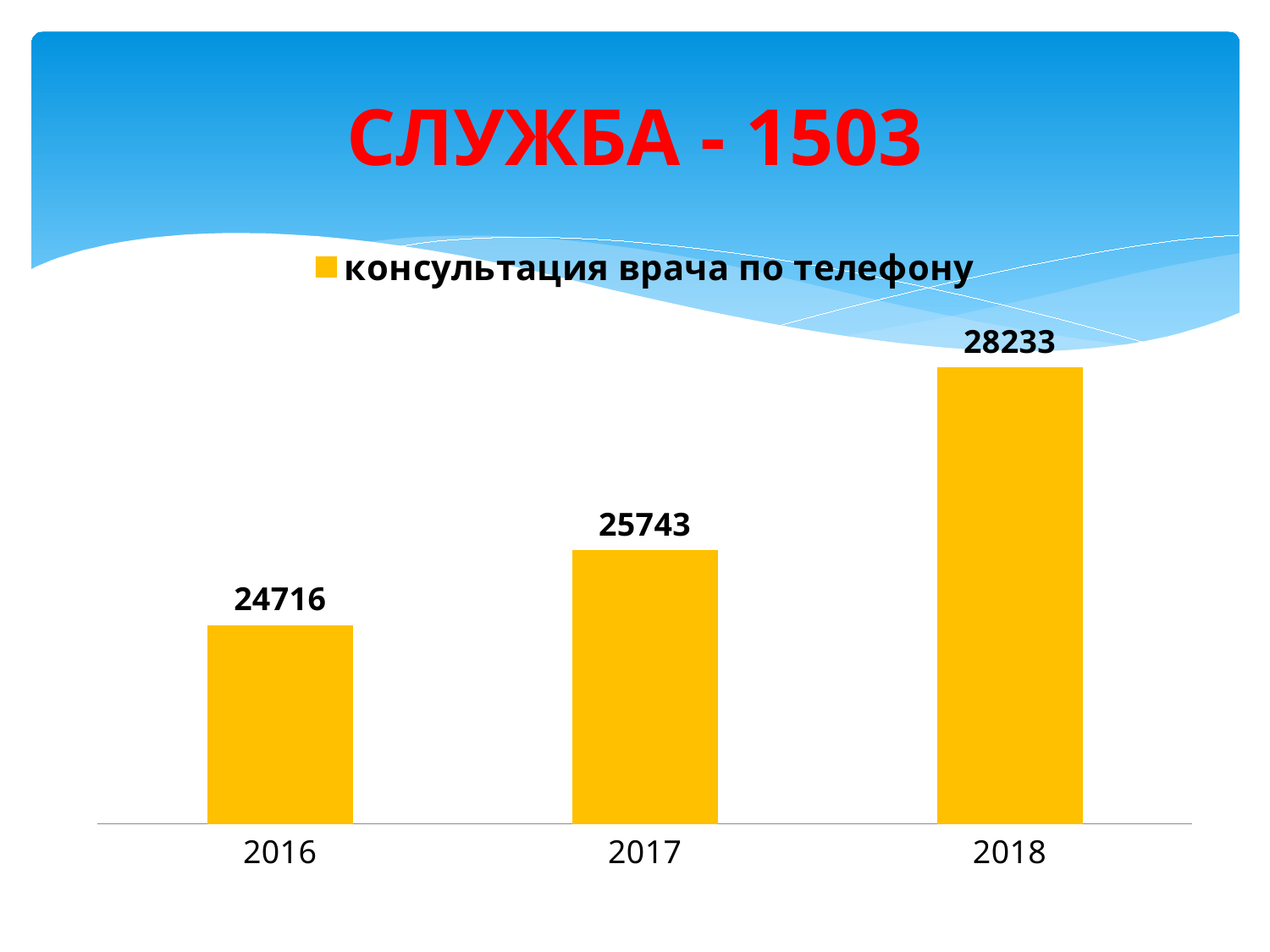
Which is larger, the value for 2017 or the value for 2018? 2018 Do the values rise or fall from 2016 to 2018? rise Which year has the highest value? 2018 Which year has the lowest value? 2016 How many series does the legend list? 1 How many years are shown on the x axis? 3 What is the value for 2016? 24716 What is the difference between the values for 2018 and 2016? 3517 What is the value for 2018? 28233 What is the value for 2017? 25743 What kind of chart is shown? bar chart What is the difference between the values for 2017 and 2016? 1027